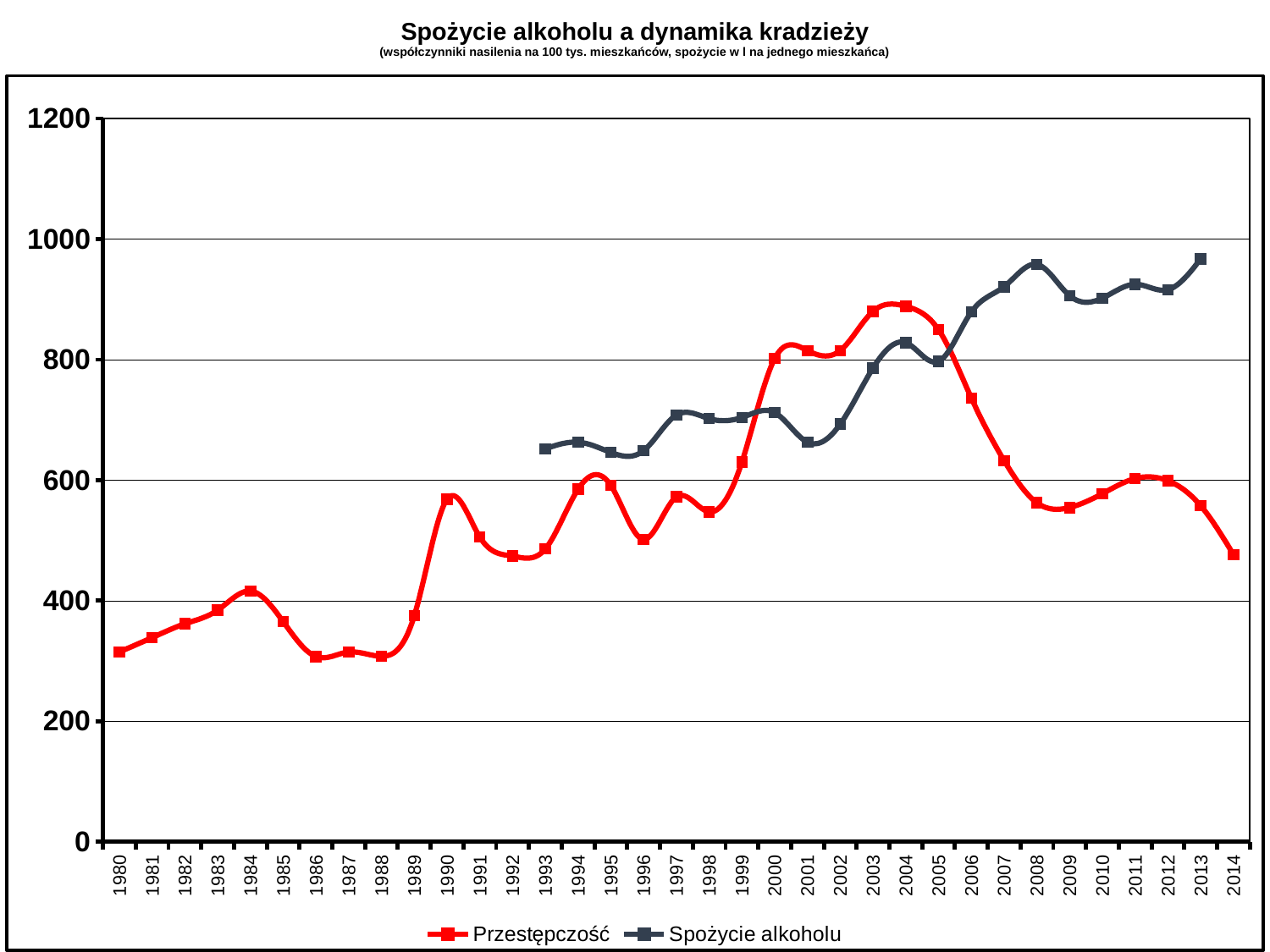
In which year does the Spożycie alkoholu series begin? 1993 Does the Spożycie alkoholu series generally rise or fall between 1993 and 2008? rise Is the value for Przestępczość in 2014 greater or less than 600? less Is the value for Przestępczość in 2004 greater or less than 800? greater What kind of chart is shown on the slide? line chart Is the value for Przestępczość in 1980 greater or less than 400? less In 2008, which series has the higher value, Przestępczość or Spożycie alkoholu? Spożycie alkoholu How many series does the legend list? 2 Does the Przestępczość series rise or fall between 2004 and 2009? fall In 2000, which series has the higher value, Przestępczość or Spożycie alkoholu? Przestępczość How many years are shown on the x axis? 35